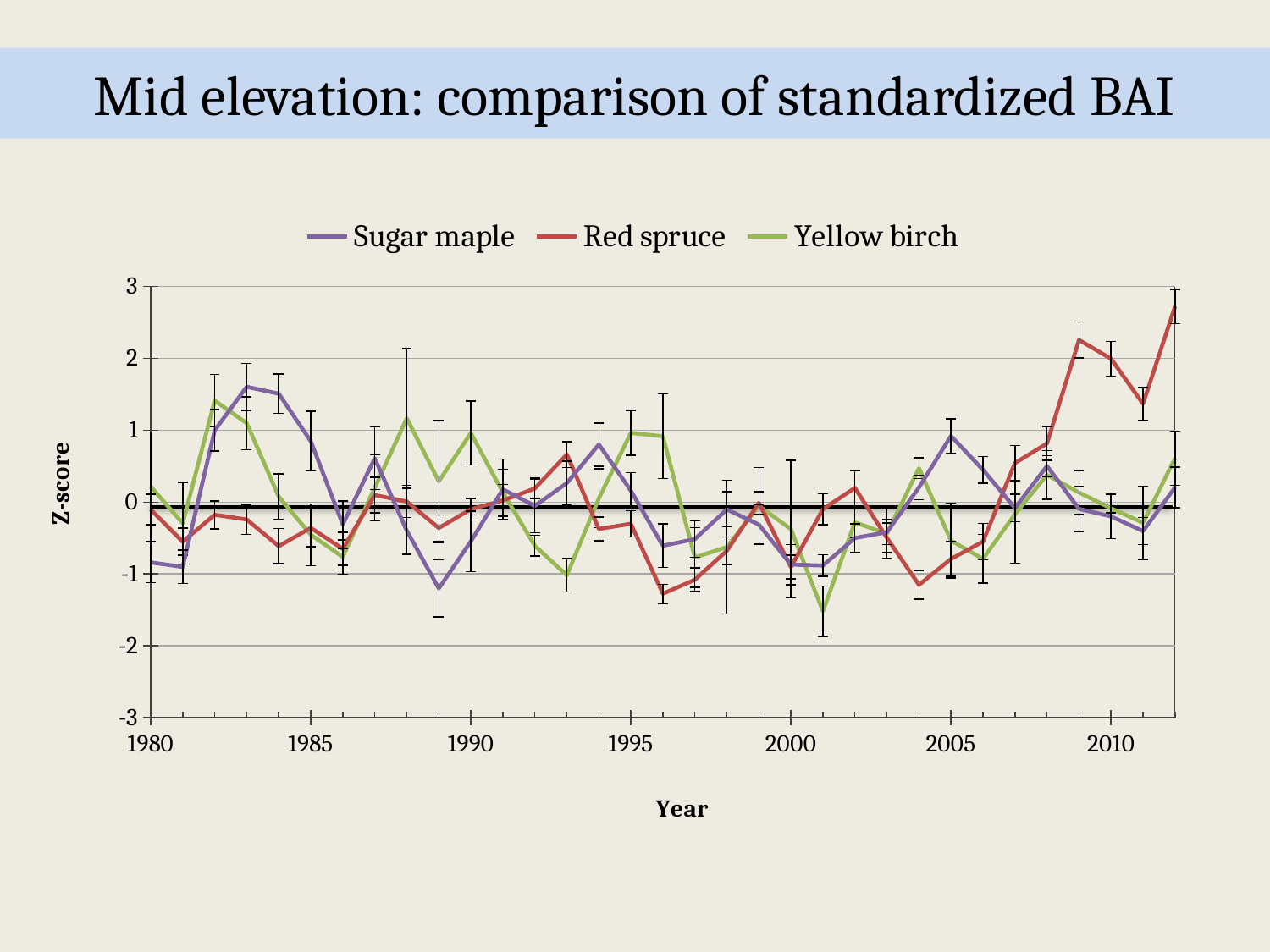
In which year does the Red spruce series reach its highest value? 2012 What kind of chart is shown on the slide? Line chart Is the Sugar maple value in 1983 greater or less than 1? greater Is the Red spruce value in 2012 greater or less than 2? greater Does the Red spruce series rise or fall between 2007 and 2009? rise Is the Yellow birch value in 2001 greater or less than -1? less Which three species are listed in the legend? Sugar maple, Red spruce, Yellow birch What is the label of the vertical axis? Z-score Which series reaches the highest value anywhere on the chart? Red spruce In 2012, which is larger: the Red spruce value or the Sugar maple value? Red spruce Which series has the lowest value anywhere on the chart? Yellow birch How many series does the legend list? 3